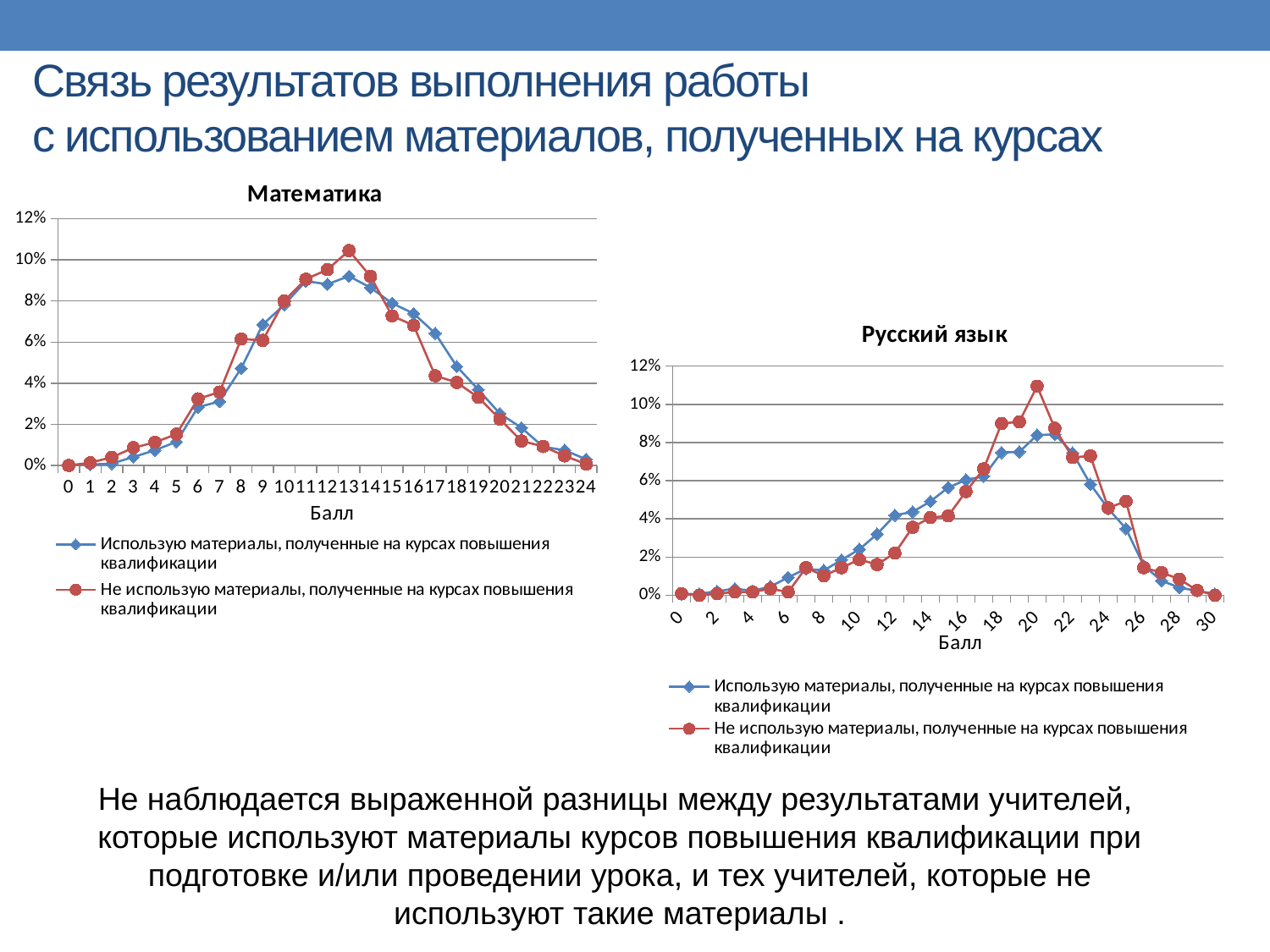
In the "Математика" chart, does the "Использую материалы" series rise or fall from score 13 to score 24? fall In the "Математика" chart, is the value of the "Не использую материалы" series at score 21 greater or less than 2%? less In the "Математика" chart, at which score does the "Не использую материалы" series reach its highest value? 13 How many series does the legend of the "Русский язык" chart list? 2 In the "Математика" chart, which series has the higher value at score 8? Не использую материалы, полученные на курсах повышения квалификации In the "Математика" chart, is the value of the "Не использую материалы" series at score 13 greater or less than 10%? greater How many score values (points) are plotted along the x axis of the "Математика" chart? 25 In the "Математика" chart, is the value of the "Использую материалы" series at score 13 greater or less than 10%? less In the "Русский язык" chart, at which score does the "Не использую материалы" series reach its highest value? 20 What is the x-axis label of the "Русский язык" chart? Балл What type of chart is the "Математика" chart? line chart